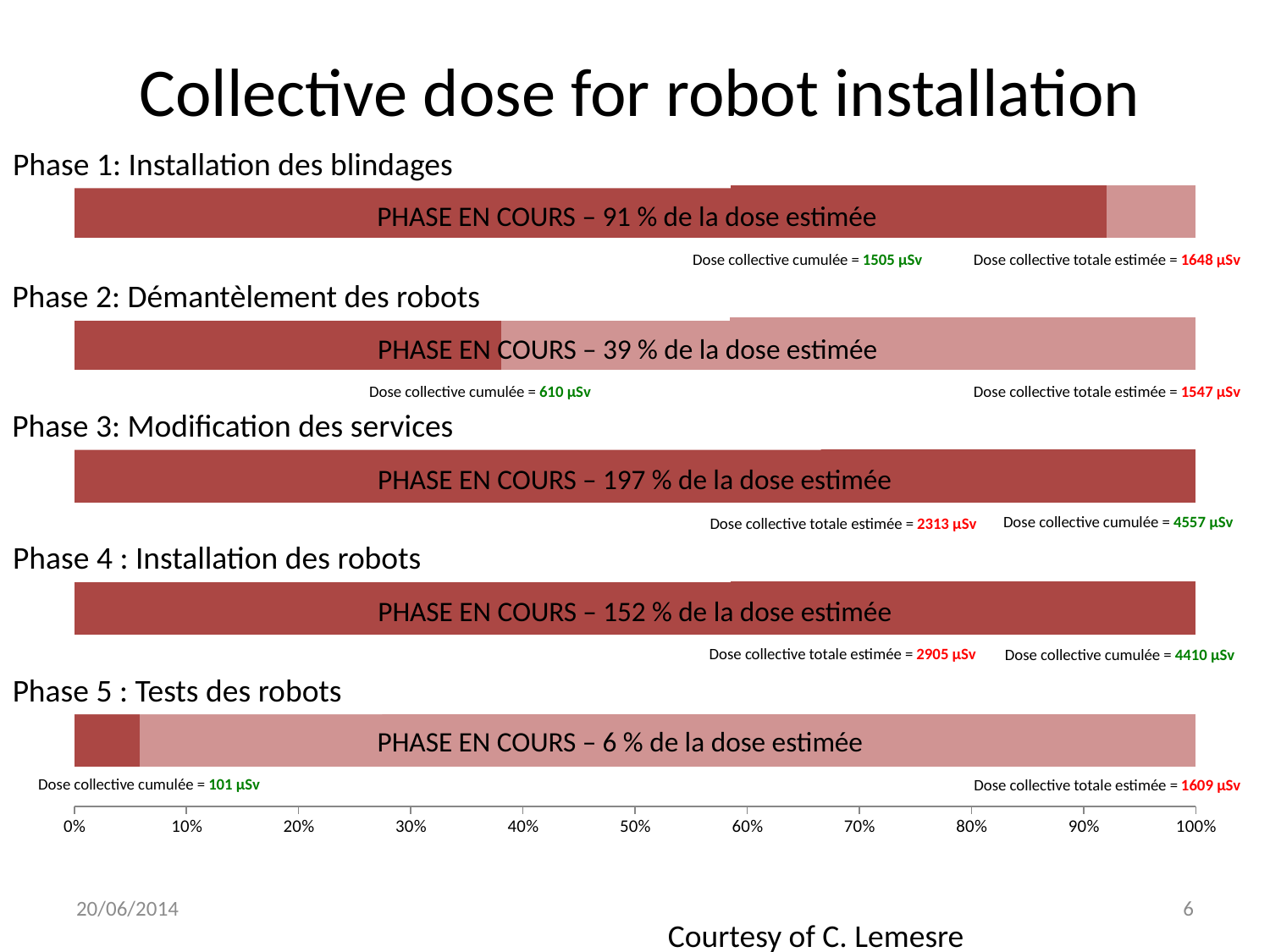
Which is larger: the cumulative dose of Phase 3 or the cumulative dose of Phase 4? Phase 3 What is the cumulative collective dose for Phase 4: Installation des robots? 4410 µSv For Phase 1, what is the difference between the total estimated dose and the cumulative dose? 143 µSv How many phases are shown on the slide? 5 What is the total estimated collective dose (Dose collective totale estimée) for Phase 5: Tests des robots? 1609 µSv What kind of chart is used to show the progress of each phase? Bar chart What percentage of the estimated dose has been reached in Phase 1: Installation des blindages? 91 % For Phase 3, by how much does the cumulative dose exceed the total estimated dose? 2244 µSv Which phase has the highest total estimated collective dose? Phase 4 : Installation des robots Which phase shows the highest percentage of the estimated dose? Phase 3: Modification des services What is the cumulative collective dose (Dose collective cumulée) for Phase 2: Démantèlement des robots? 610 µSv Which phase shows the lowest percentage of the estimated dose? Phase 5: Tests des robots